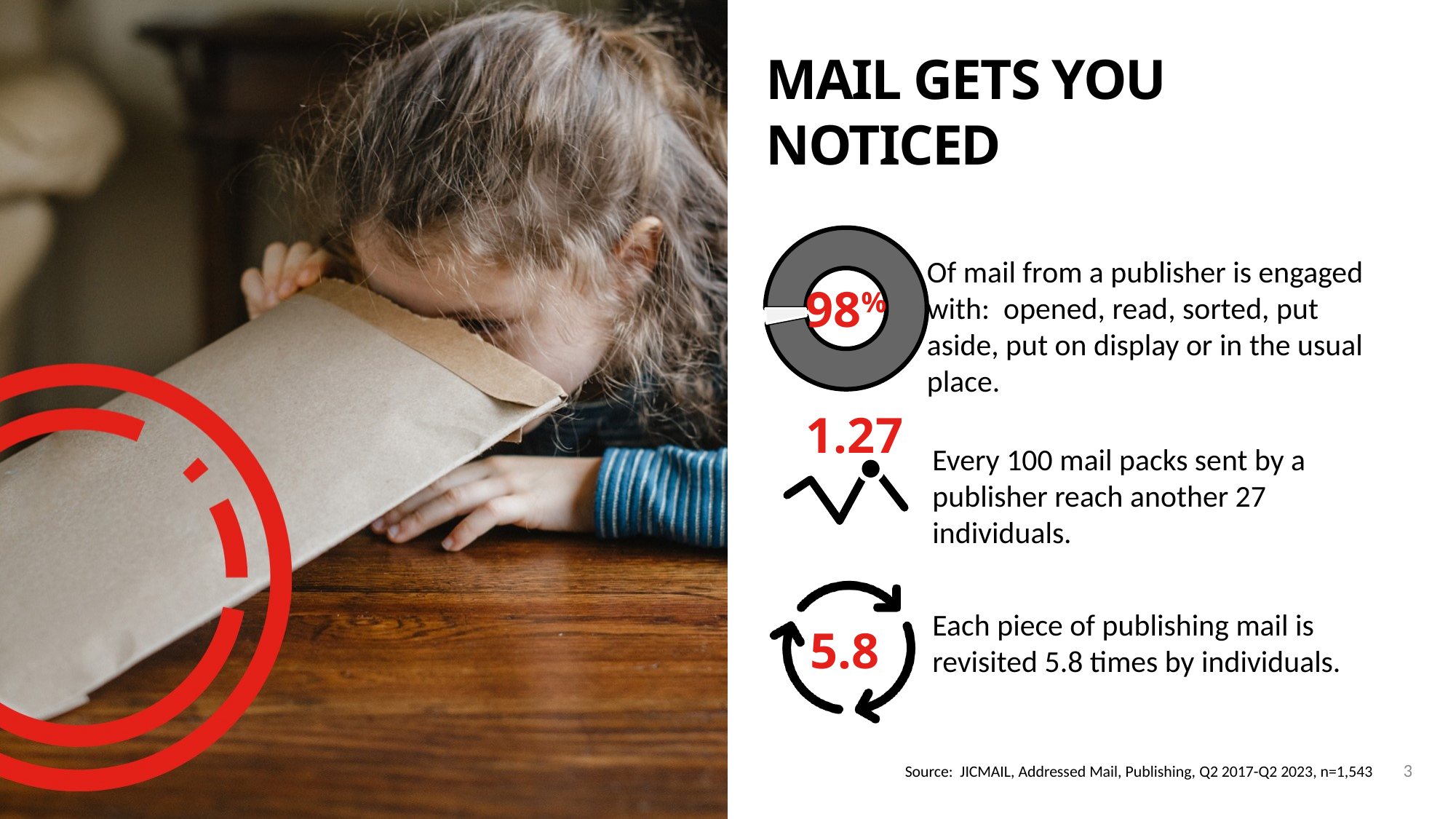
What colour is the 98% label in the donut chart? red Is the value shown in the donut chart greater or less than 90%? greater What kind of chart is shown next to the text about mail from a publisher being engaged with? pie chart (donut) What percentage is printed in the centre of the donut chart? 98% How many slices does the donut chart have? 2 According to the donut chart, what share of mail from a publisher is engaged with? 98% Which slice of the donut chart is larger, the grey slice or the white slice? the grey slice What colour is the large slice of the donut chart? grey